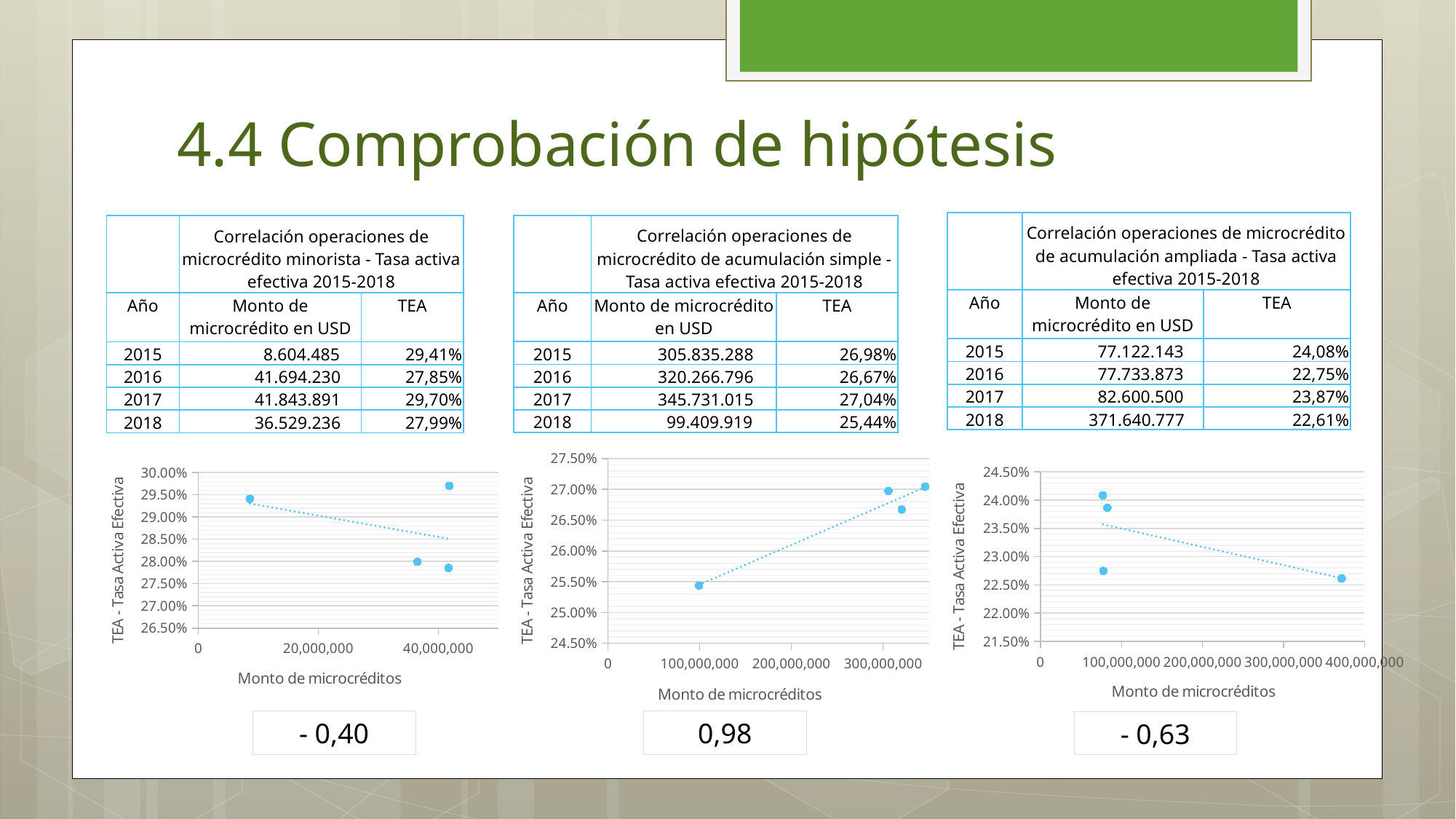
What kind of chart is the left chart titled 'Correlación operaciones de microcrédito minorista - Tasa activa efectiva 2015-2018'? Scatter chart In the left chart (microcrédito minorista), is the TEA of the point closest to 0 on the x axis greater or less than 29.00%? greater In the middle chart (microcrédito de acumulación simple), is the TEA of the point near 100,000,000 on the x axis greater or less than 26.00%? less What correlation value is shown in the box below the middle chart (microcrédito de acumulación simple)? 0,98 According to the table above the right chart, what is the monto de microcrédito en USD for 2018 for microcrédito de acumulación ampliada? 371.640.777 In the left chart (microcrédito minorista), does the dotted trend line rise or fall as the monto de microcréditos increases? Falls In the right chart (microcrédito de acumulación ampliada), does the dotted trend line rise or fall as the monto de microcréditos increases? Falls How many data points are plotted in the middle chart (microcrédito de acumulación simple)? 4 In the right chart (microcrédito de acumulación ampliada), is the TEA of the point near 400,000,000 on the x axis greater or less than 23.00%? less According to the table above the left chart, what is the TEA for 2017 for microcrédito minorista? 29,70% What is the label of the y axis on the right chart (microcrédito de acumulación ampliada)? TEA - Tasa Activa Efectiva In the middle chart (microcrédito de acumulación simple), does the dotted trend line rise or fall as the monto de microcréditos increases? Rises